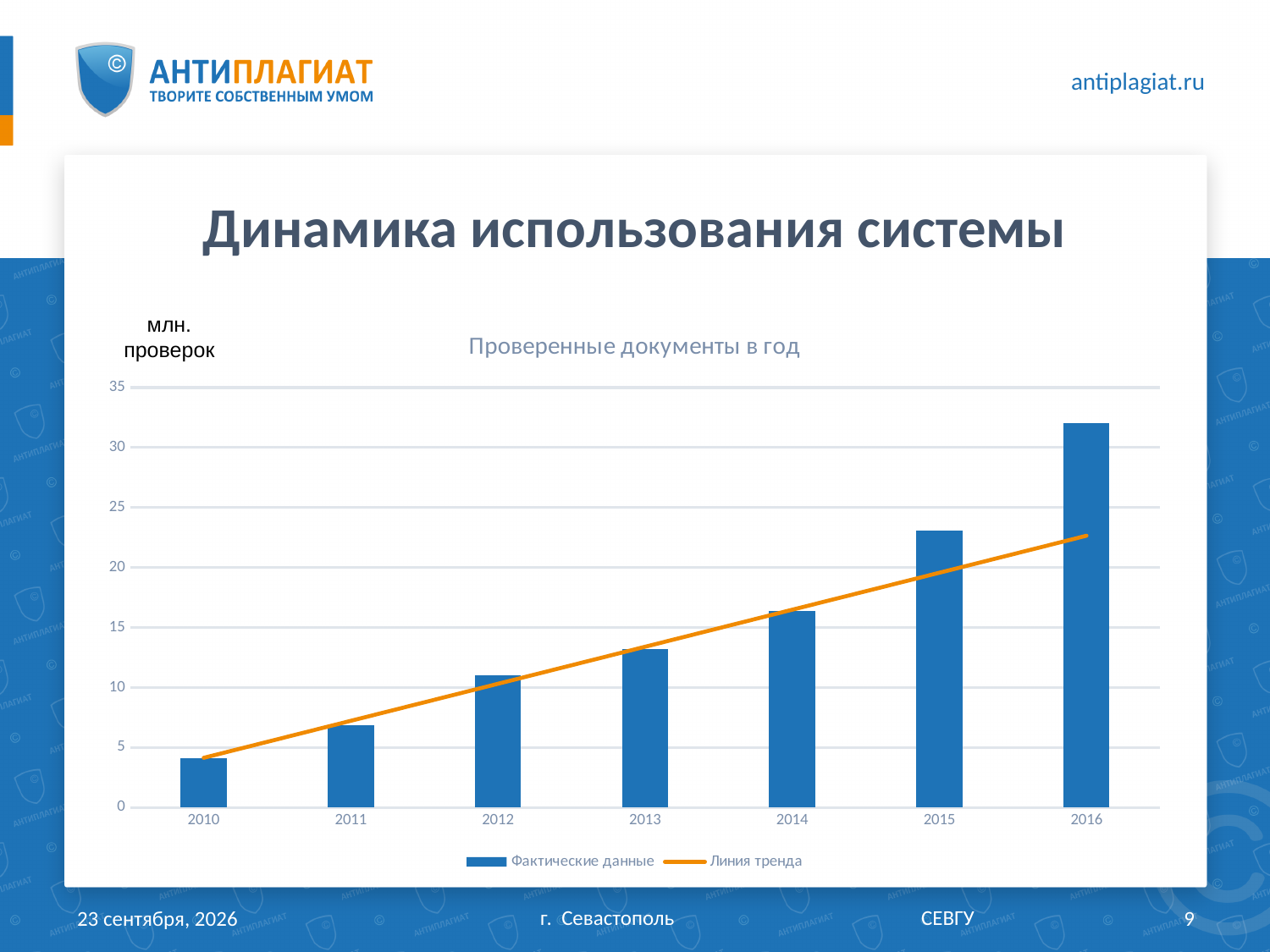
Do the values rise or fall from 2010 to 2016? rise Is the value for 2010 greater or less than 5? less Which year has the lowest number of checked documents? 2010 Which year has the highest number of checked documents? 2016 Is the value for 2016 greater or less than 30? greater How many series does the legend list? 2 What type of chart is shown on the slide? combination bar and line chart Is the value for 2015 greater or less than 20? greater How many years are shown on the x axis? 7 Which year has a larger value, 2014 or 2012? 2014 What is the title of the chart? Проверенные документы в год